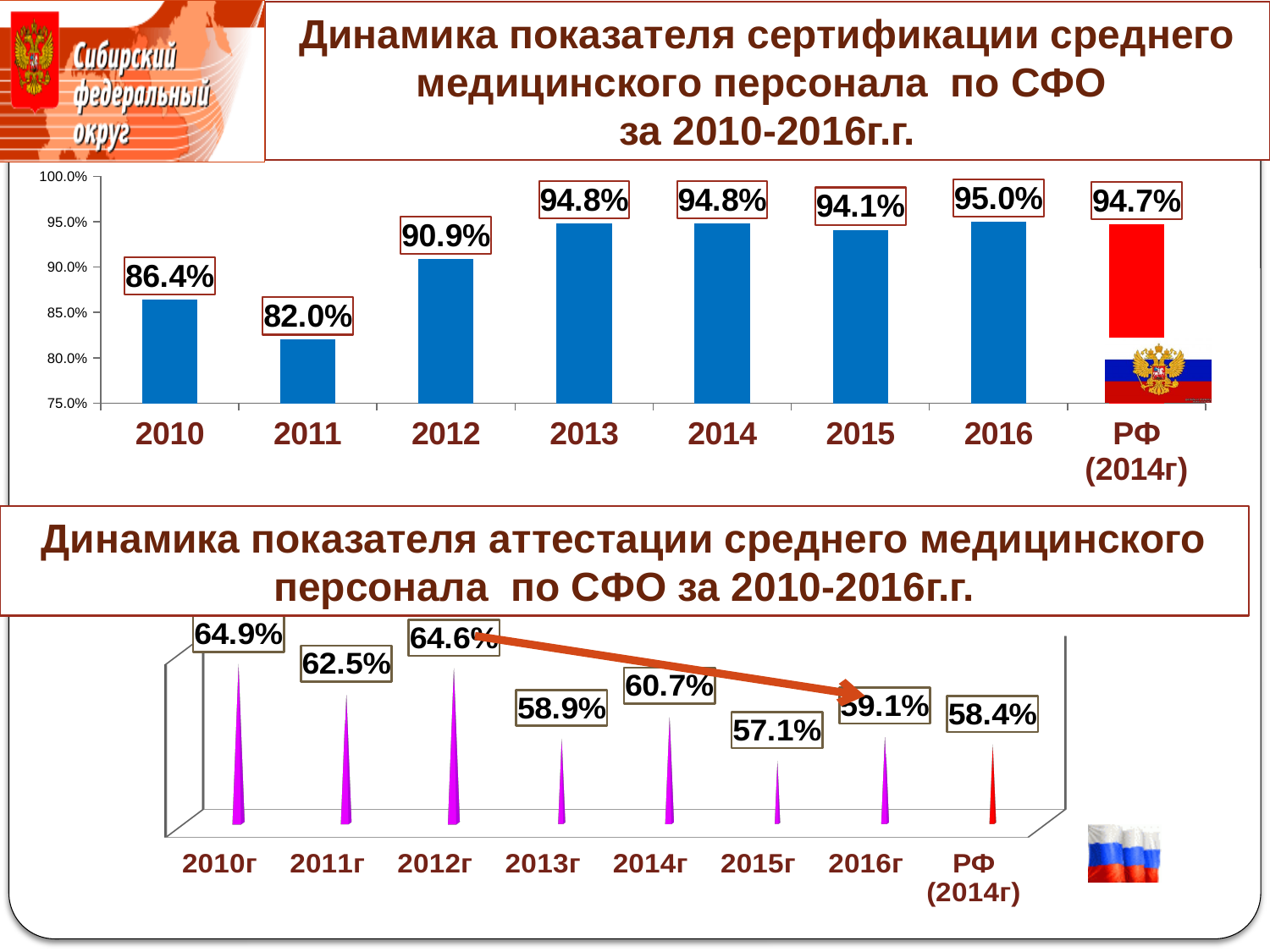
What kind of chart is the top chart (certification)? bar chart In the top chart (certification), is the value for 2011 greater or less than 85.0%? less In the bottom chart (attestation), what is the difference between the values for 2010г and 2015г? 7.8% In the bottom chart (attestation), which is larger: the value for 2016г or the value for РФ (2014г)? 2016г In the top chart (certification), which year has the highest value? 2016 In the top chart (certification), what is the difference between the values for 2012 and 2011? 8.9% In the top chart (certification of nursing staff in SFO), what is the value for 2010? 86.4% In the top chart (certification), what is the value for РФ (2014г)? 94.7% In the bottom chart (attestation), which category has the highest value? 2010г In the bottom chart (attestation), what is the value for 2015г? 57.1% How many categories are shown on the x axis of the top chart (certification)? 8 In the top chart (certification), which category has the lowest value? 2011